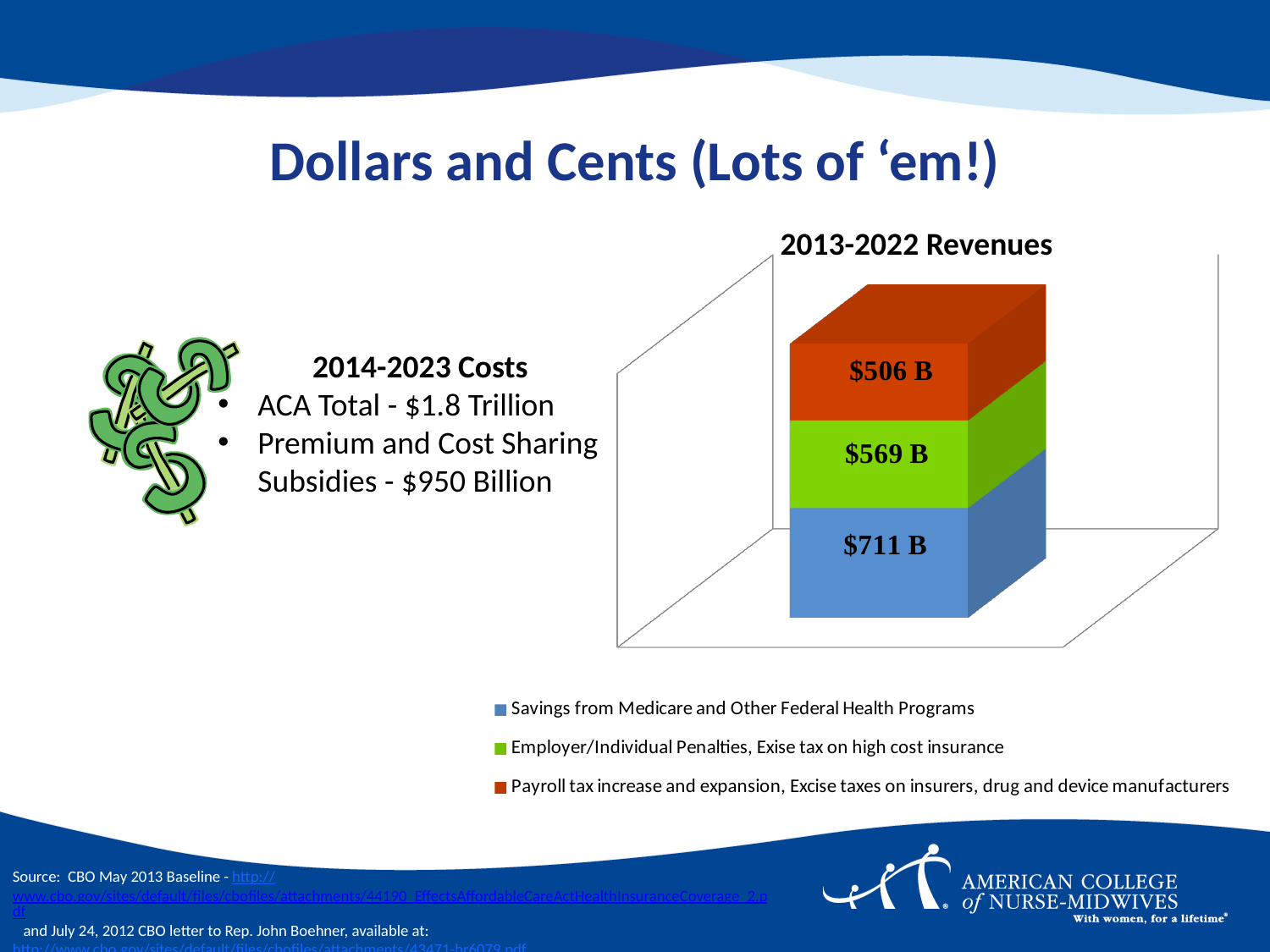
What is the total of the stacked bar in the "2013-2022 Revenues" chart? $1,786 B Which segment of the "2013-2022 Revenues" stacked bar has the largest value? Savings from Medicare and Other Federal Health Programs How many series does the legend of the "2013-2022 Revenues" chart list? 3 In the "2013-2022 Revenues" chart, what is the value for Employer/Individual Penalties, Exise tax on high cost insurance? $569 B What is the title of the chart on the slide? 2013-2022 Revenues In the "2013-2022 Revenues" chart, what is the difference between the Savings from Medicare and Other Federal Health Programs segment and the Employer/Individual Penalties segment? $142 B In the "2013-2022 Revenues" chart, what is the value for Savings from Medicare and Other Federal Health Programs? $711 B In the "2013-2022 Revenues" chart, what is the value for Payroll tax increase and expansion, Excise taxes on insurers, drug and device manufacturers? $506 B In the "2013-2022 Revenues" chart, which is larger: the Savings from Medicare segment or the Payroll tax increase segment? Savings from Medicare and Other Federal Health Programs In the "2013-2022 Revenues" chart, what is the difference between the Employer/Individual Penalties segment and the Payroll tax increase segment? $63 B What kind of chart is shown under the title "2013-2022 Revenues"? Stacked bar chart Which segment of the "2013-2022 Revenues" stacked bar has the smallest value? Payroll tax increase and expansion, Excise taxes on insurers, drug and device manufacturers